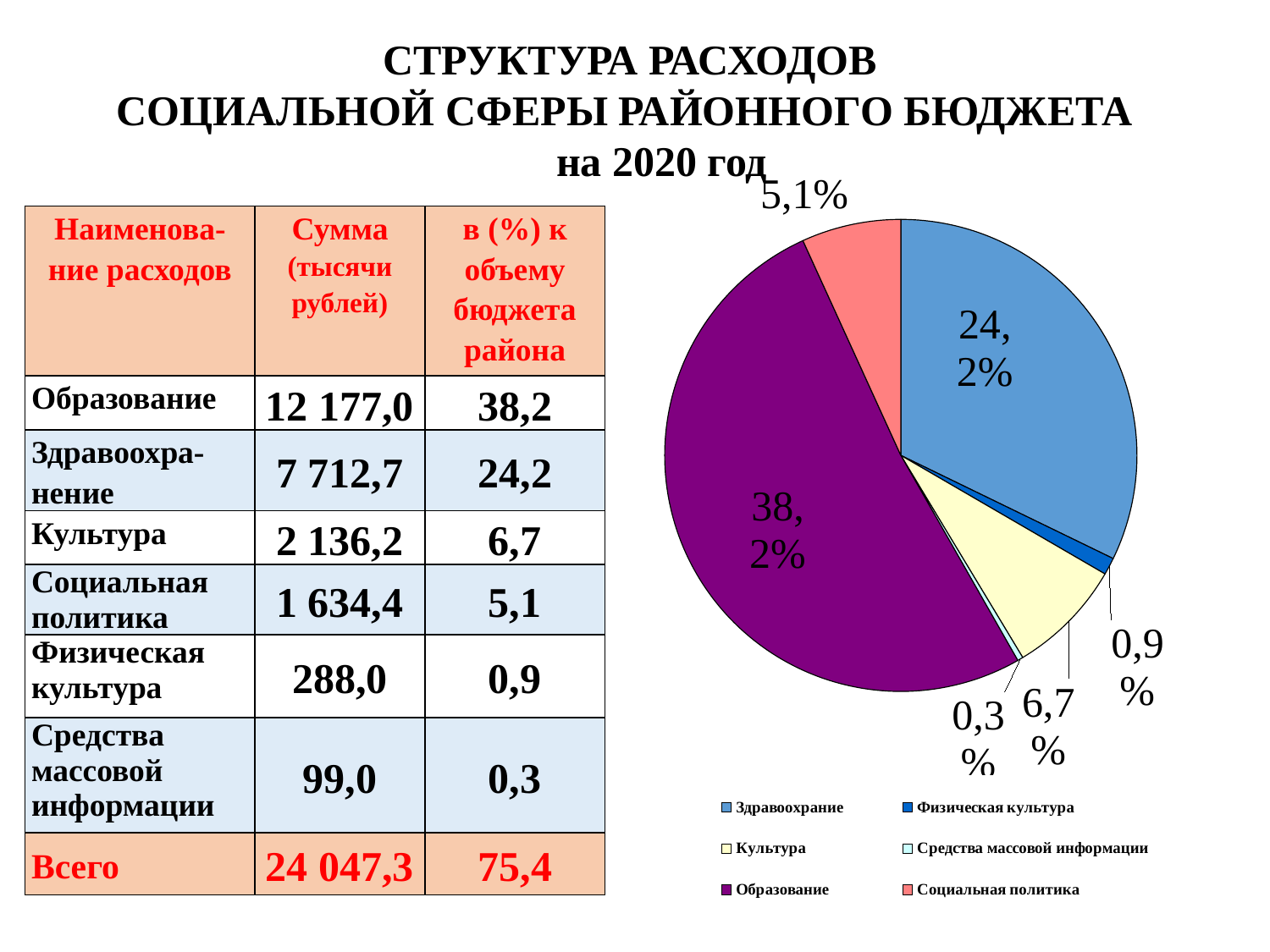
What colour is the Образование slice in the pie chart? purple Which category has the largest slice in the pie chart? Образование How many entries does the pie chart's legend list? 6 What percentage does the pie chart show for Образование? 38,2% Which slice is larger in the pie chart, Здравоохранение or Культура? Здравоохранение Which category has the smallest slice in the pie chart? Средства массовой информации How many slices does the pie chart have? 6 What type of chart is shown on the slide? pie chart What percentage does the pie chart show for Культура? 6,7% What percentage does the pie chart show for Социальная политика? 5,1% What percentage does the pie chart show for Средства массовой информации? 0,3% What percentage does the pie chart show for Здравоохранение? 24,2%